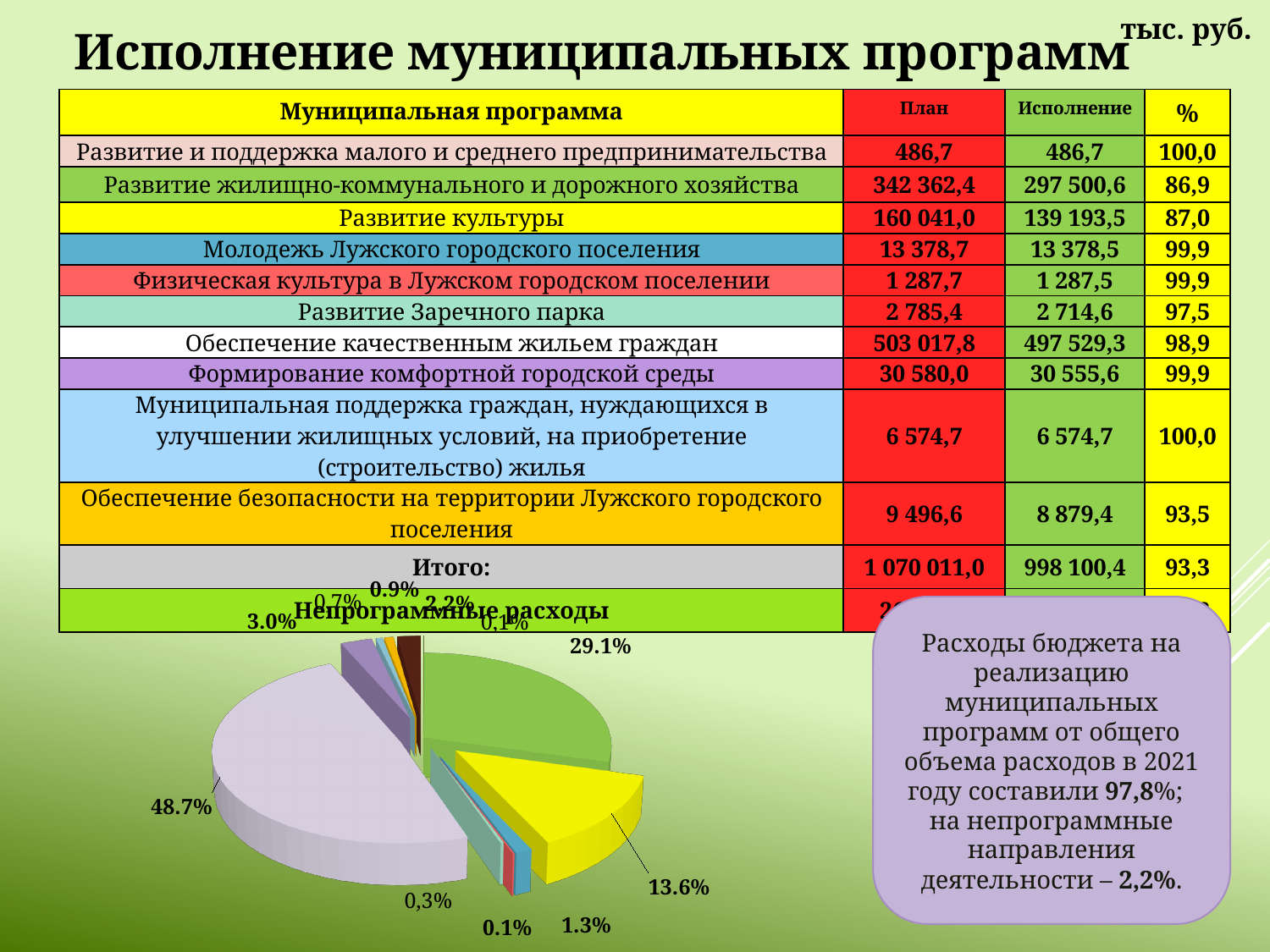
What colour is the largest slice of the pie chart? white (light grey) In the pie chart, what is the share of the second-largest slice? 29.1% How many slices are labelled in the pie chart? 11 In the pie chart, which is larger: the green slice at 29.1% or the yellow slice at 13.6%? the green slice (29.1%) In the pie chart, is the largest slice greater or less than 40%? greater In the pie chart, what is the share of the largest slice? 48.7% In the pie chart, what is the combined share of the 48.7% and 29.1% slices? 77.8% In the pie chart, what is the difference in percentage points between the 29.1% slice and the 13.6% slice? 15.5 In the pie chart, what is the share of the yellow slice? 13.6% In the pie chart, what is the share of the smallest labelled slice? 0.1% What kind of chart is shown at the bottom left of the slide? pie chart Does the pie chart have a legend? No